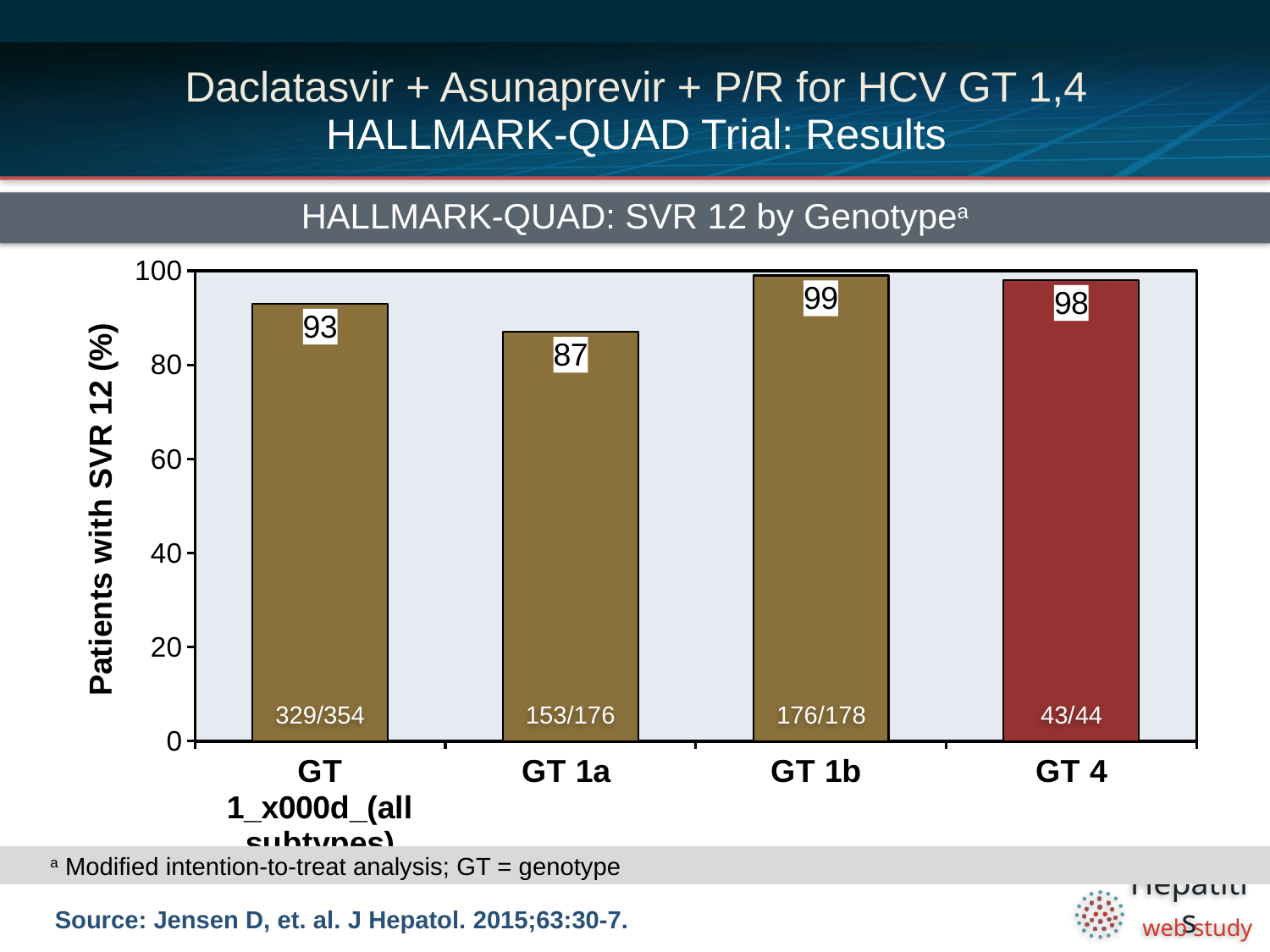
What patient fraction is printed inside the GT 4 bar? 43/44 What is the SVR 12 rate (%) for GT 1b? 99 How many genotype groups are plotted in the chart? 4 What is the difference in SVR 12 rate between GT 1b and GT 1a? 12 What is the SVR 12 rate (%) for GT 4? 98 Which has a higher SVR 12 rate, GT 4 or GT 1a? GT 4 What type of chart is shown on the slide? Bar chart What patient fraction is printed inside the GT 1b bar? 176/178 Which genotype group has the lowest SVR 12 rate? GT 1a Which genotype group has the highest SVR 12 rate? GT 1b What is the SVR 12 rate (%) for GT 1a? 87 What is the SVR 12 rate (%) shown on the leftmost bar, GT 1 (all subtypes)? 93